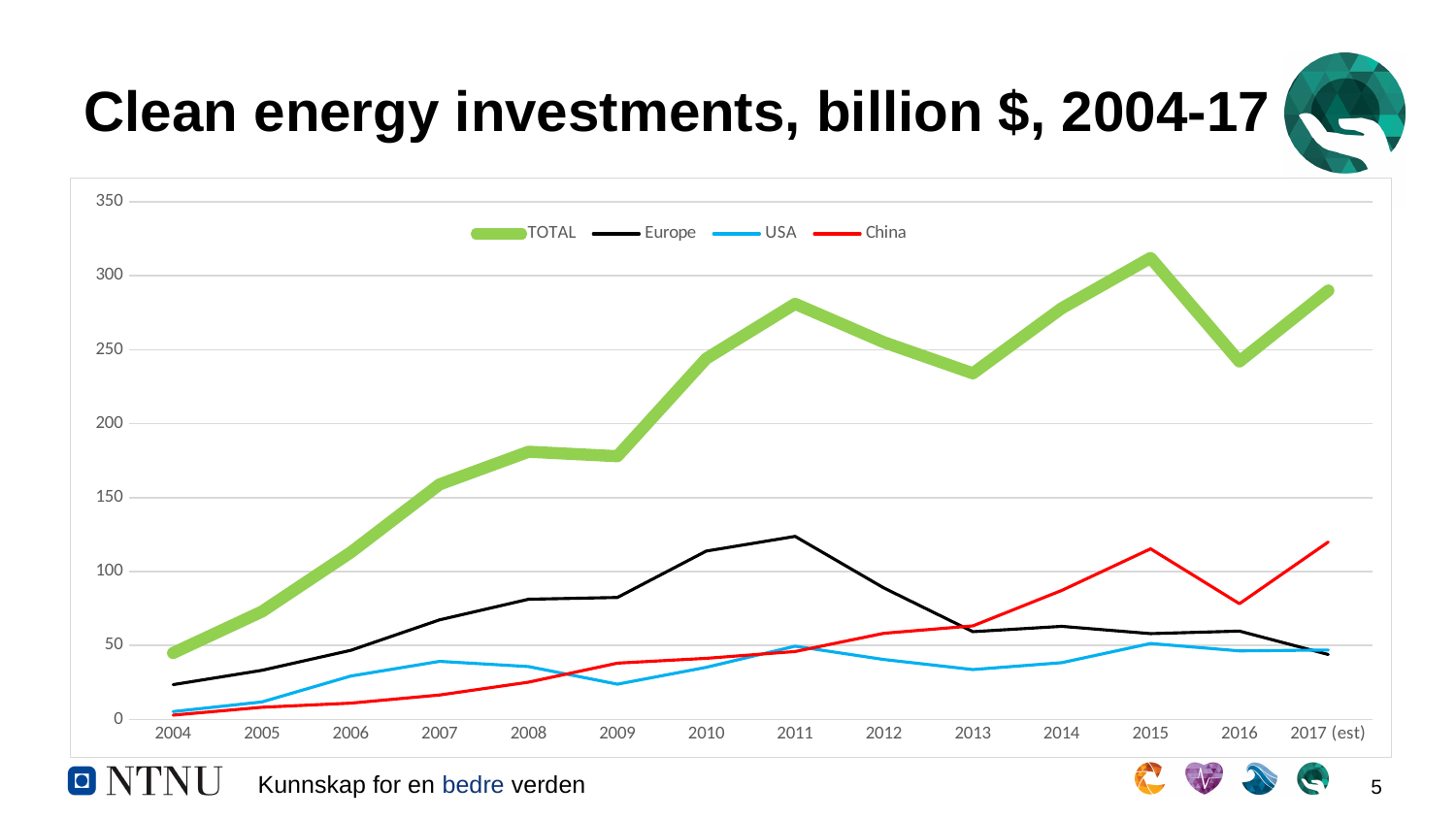
Does the TOTAL series rise or fall from 2004 to 2011? rise Which series has the higher value in 2017 (est), China or Europe? China How many series does the legend list? 4 What type of chart is shown on the slide? Line chart In which year does the TOTAL series reach its highest value? 2015 Is the TOTAL value for 2015 greater or less than 300? greater In which year does the Europe series reach its highest value? 2011 What is the title of the chart? Clean energy investments, billion $, 2004-17 Is the China value for 2004 greater or less than 50? less Is the Europe value for 2011 greater or less than 100? greater How many years are shown along the x axis? 14 In which year is the TOTAL series at its lowest value? 2004